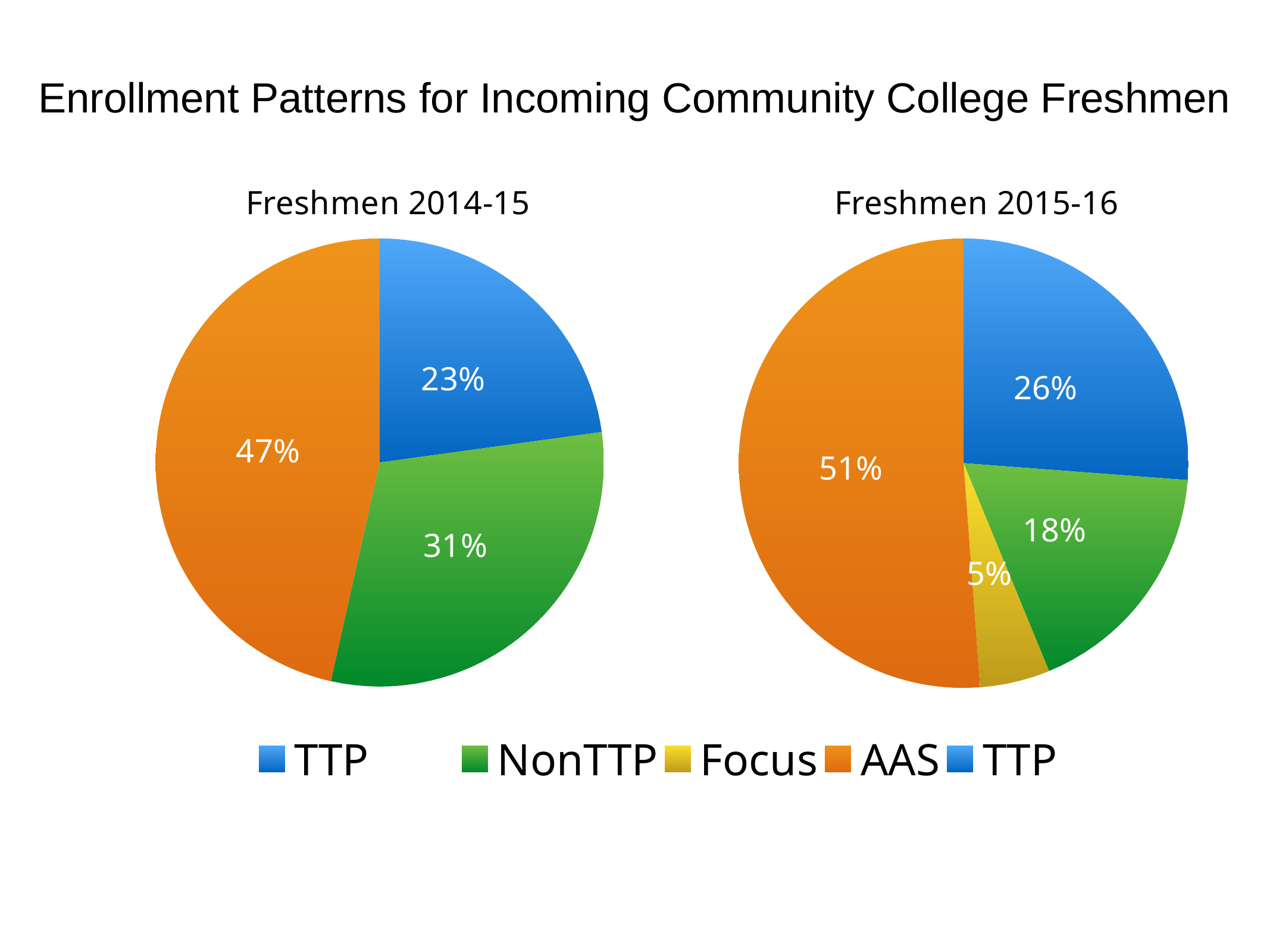
How many slices does the Freshmen 2014-15 pie chart have? 3 In the Freshmen 2014-15 chart, what share does AAS have? 47% Which colour represents AAS in the pie charts? orange In the Freshmen 2015-16 chart, which category has the smallest slice? Focus In the Freshmen 2015-16 chart, which category has the largest slice? AAS How many slices does the Freshmen 2015-16 pie chart have? 4 What is the difference between the AAS share in the Freshmen 2015-16 chart and the AAS share in the Freshmen 2014-15 chart? 4% In the Freshmen 2014-15 chart, what share does NonTTP have? 31% In the Freshmen 2015-16 chart, what share does Focus have? 5% What kind of chart is the Freshmen 2014-15 chart? pie chart In the Freshmen 2015-16 chart, what share does TTP have? 26% In the Freshmen 2014-15 chart, which category has the smallest slice? TTP